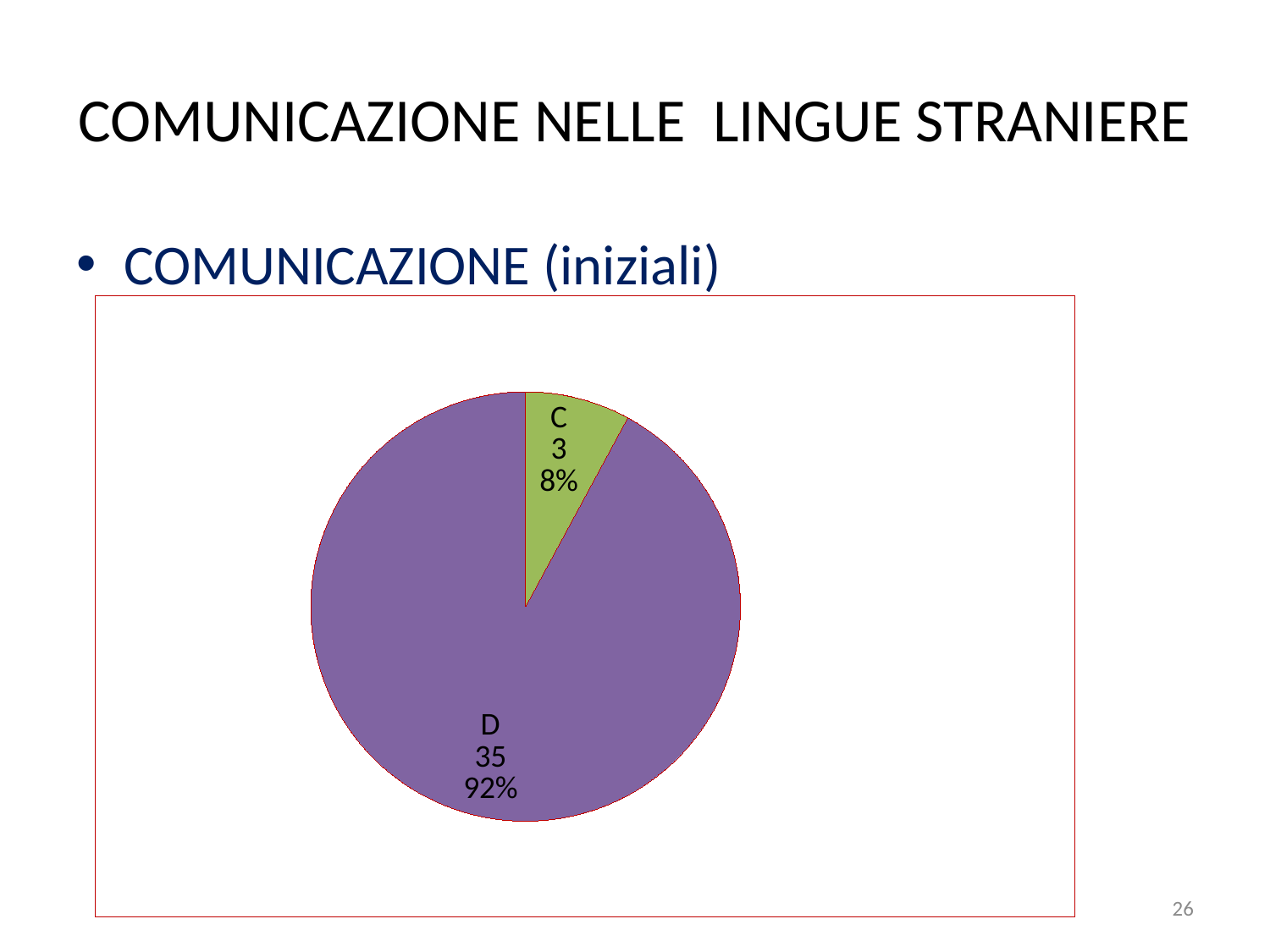
How many slices does the pie chart have? 2 What percentage share does slice C have? 8% What kind of chart is shown on the slide? pie chart What percentage share does slice D have? 92% What colour is the slice for D? purple Which is larger, the value for C or the value for D? D What is the value for slice C? 3 Which slice is the smallest? C What is the total of the values shown in the pie chart? 38 Which slice is the largest? D What is the value for slice D? 35 What is the difference between the values for D and C? 32